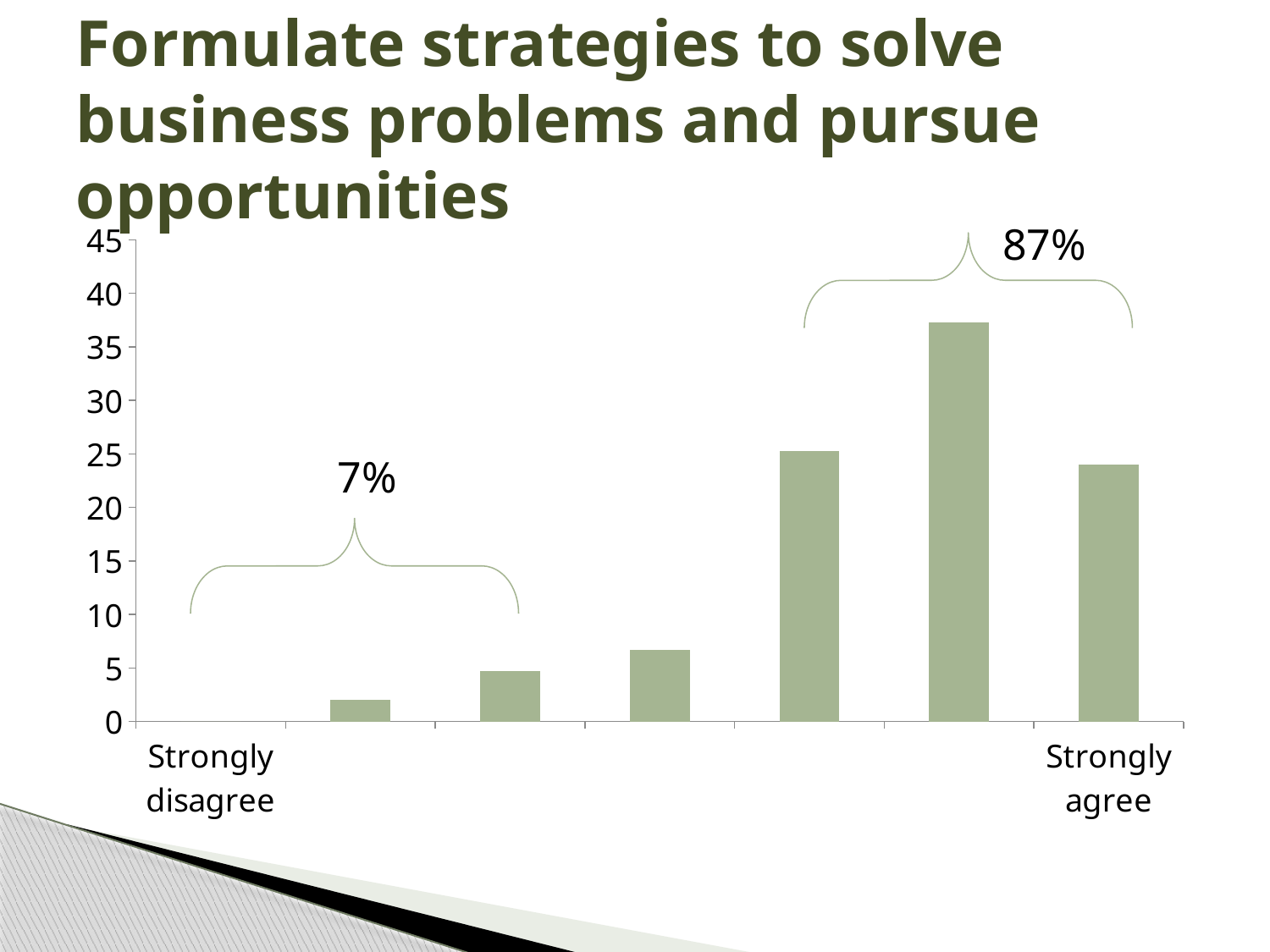
Is the value for Strongly disagree greater or less than 5? less Is the tallest bar the one labelled Strongly agree? No What is the title of the slide containing the chart? Formulate strategies to solve business problems and pursue opportunities What is the highest value shown on the vertical axis? 45 Is the tallest bar in the chart greater or less than 35? greater What percentage is written above the bracket spanning the three rightmost bars? 87% Which is larger, the value for Strongly agree or the value for Strongly disagree? Strongly agree How many visible bars are plotted in the chart? 6 What percentage is written above the bracket spanning the leftmost bars? 7% What kind of chart is shown on the slide? Bar chart Is the tallest bar in the chart greater or less than 40? less